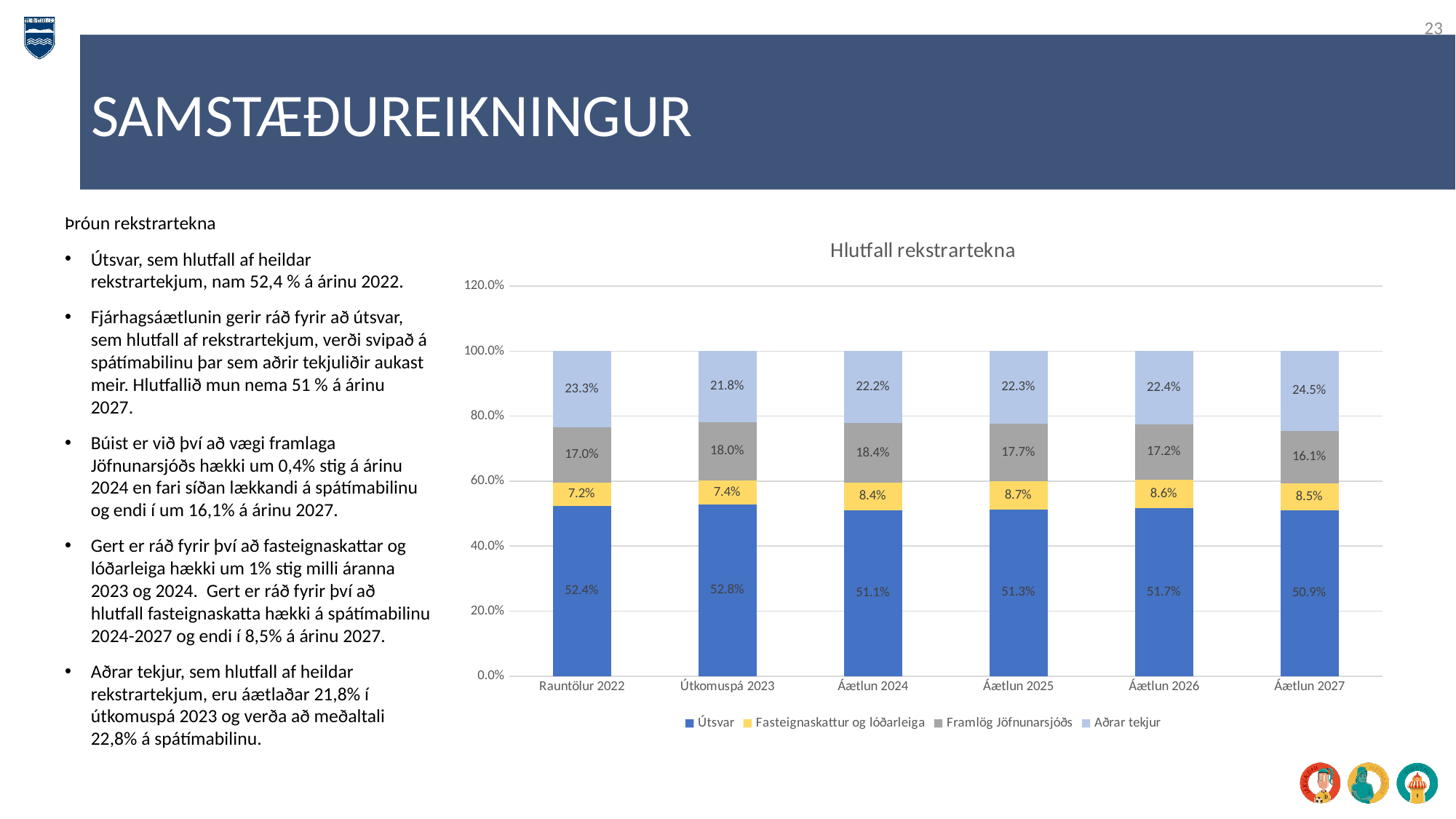
What is the difference between the Útsvar values for Útkomuspá 2023 and Áætlun 2027? 1.9% What type of chart is shown on the slide? stacked bar chart What is the Útsvar value for Rauntölur 2022? 52.4% Which category has the highest Útsvar value? Útkomuspá 2023 Which is larger, the Aðrar tekjur value for Áætlun 2027 or for Áætlun 2024? Áætlun 2027 What is the title of the chart on the slide? Hlutfall rekstrartekna What is the Aðrar tekjur value for Útkomuspá 2023? 21.8% What is the Framlög Jöfnunarsjóðs value for Áætlun 2027? 16.1% Does the Útsvar value rise or fall from Útkomuspá 2023 to Áætlun 2024? fall How many categories are shown along the x axis of the chart? 6 How many series does the chart legend list? 4 Which category has the lowest Fasteignaskattur og lóðarleiga value? Rauntölur 2022